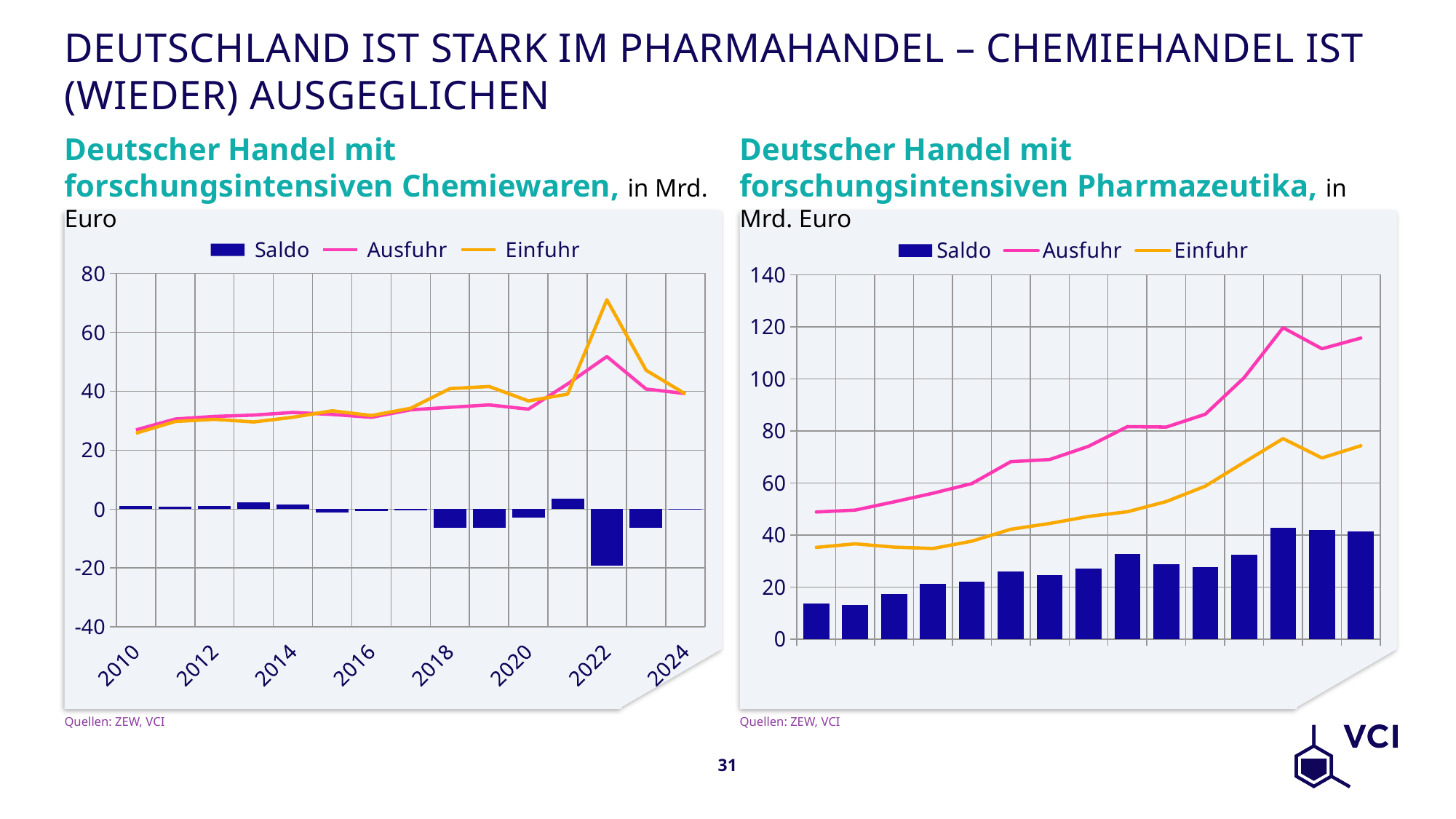
On the left chart (Chemiewaren), is the Einfuhr value for 2022 greater or less than 60? greater On the left chart (Chemiewaren), in which year does the Einfuhr line reach its highest point? 2022 On the left chart (Chemiewaren), which is larger in 2022, Ausfuhr or Einfuhr? Einfuhr On the left chart (Deutscher Handel mit forschungsintensiven Chemiewaren), how many series does the legend list? 3 On the left chart (Chemiewaren), is the Saldo value for 2022 greater or less than -10? less On the right chart (Pharmazeutika), is the highest point of the Ausfuhr line greater or less than 100? greater On the left chart (Chemiewaren), in which year is the Saldo bar lowest? 2022 On the right chart (Deutscher Handel mit forschungsintensiven Pharmazeutika), what are the three series named in the legend? Saldo, Ausfuhr, Einfuhr On the left chart (Chemiewaren), how many years are plotted from 2010 to 2024? 15 On the right chart (Pharmazeutika), does the Ausfuhr line generally rise or fall from left to right? rise What kind of chart is the right chart (Pharmazeutika)? Combined bar and line chart